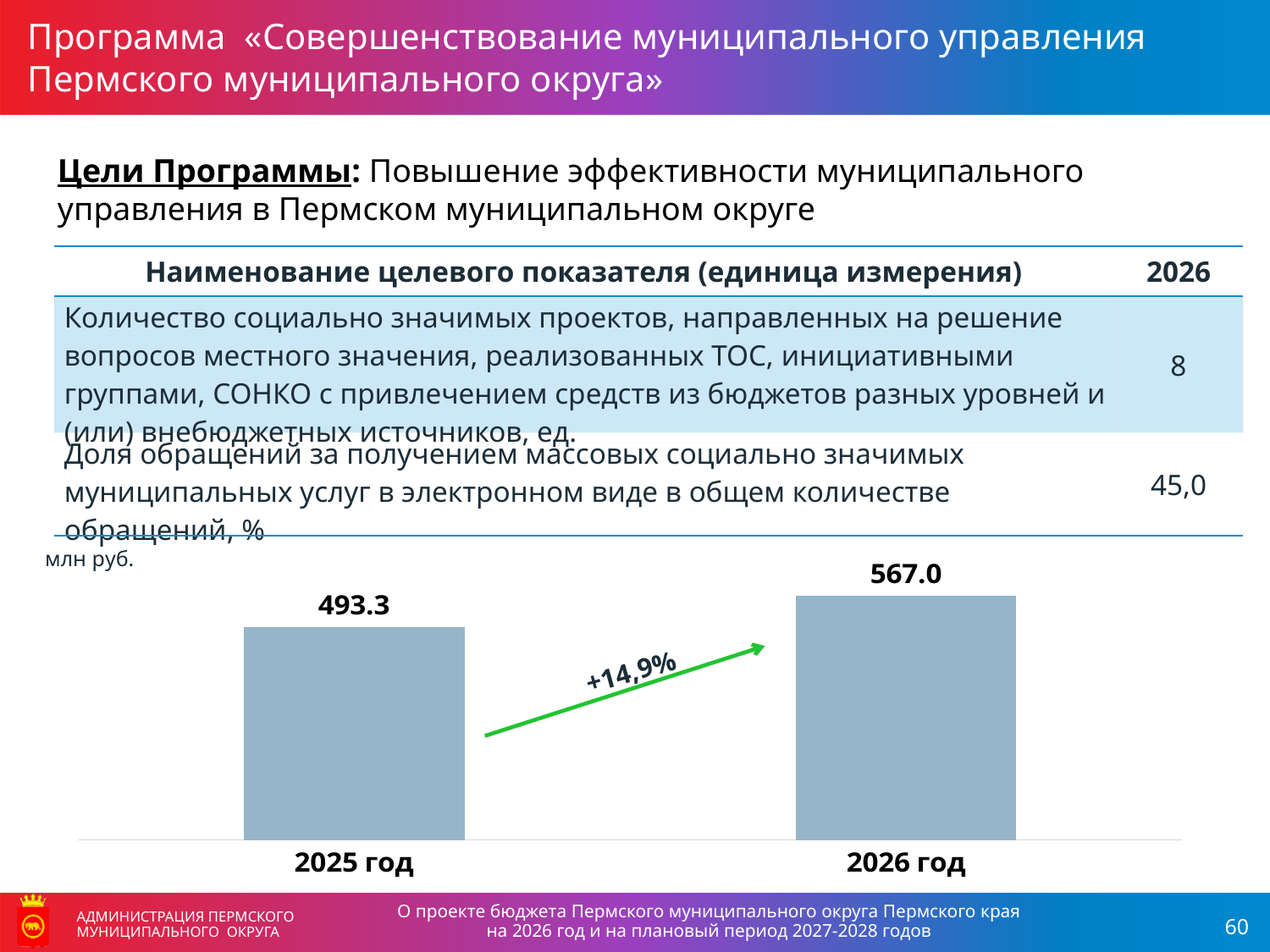
What is the value for 2025 год on the bar chart? 493.3 Do the values rise or fall from 2025 год to 2026 год? rise Which year has the lower value on the bar chart? 2025 год Is the value for 2026 год larger or smaller than the value for 2025 год? larger How many bars are shown on the chart? 2 What percentage change is shown on the arrow between the two bars? +14,9% What is the value for 2026 год on the bar chart? 567.0 What is the difference between the values for 2026 год and 2025 год on the bar chart? 73.7 Which year has the higher value on the bar chart? 2026 год What unit of measurement is indicated for the bar chart? млн руб. What kind of chart is shown on the slide? bar chart